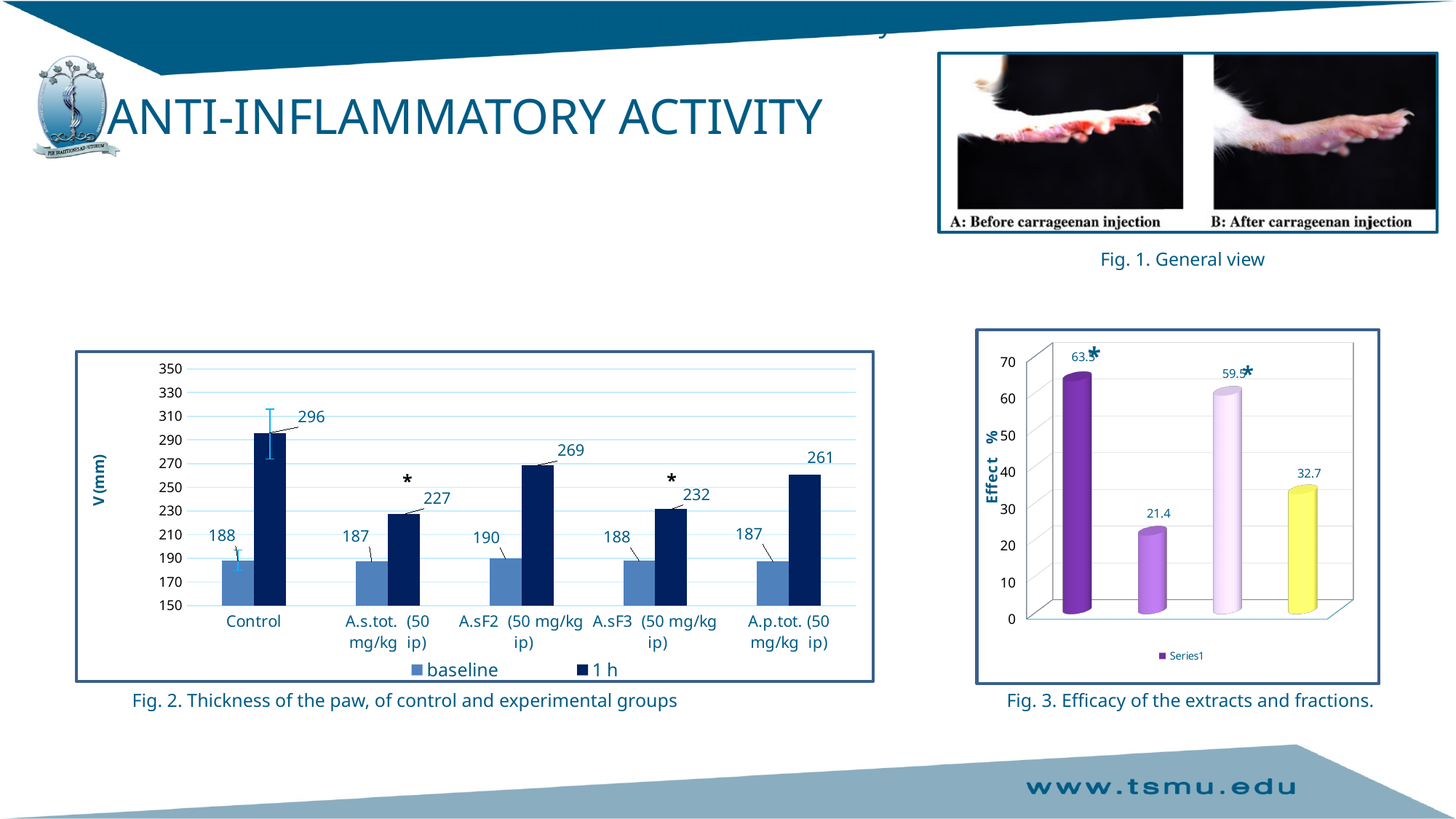
In Fig. 2, what is the difference between the 1 h and baseline values for A.p.tot. (50 mg/kg ip)? 74 In Fig. 2, what is the label of the y axis? V (mm) In Fig. 2, which is larger: the 1 h value for A.sF2 (50 mg/kg ip) or the 1 h value for A.sF3 (50 mg/kg ip)? A.sF2 (50 mg/kg ip) In Fig. 3, which bar has the lowest value? the second bar (21.4) In Fig. 3, what is the value of the first (leftmost) bar? 63.5 In Fig. 2, how many series does the legend list? 2 In Fig. 2, which group has the lowest 1 h value? A.s.tot. (50 mg/kg ip) In Fig. 2, how many groups are shown on the x axis? 5 What kind of chart is Fig. 3? bar chart In Fig. 2, what is the baseline value for A.sF2 (50 mg/kg ip)? 190 In Fig. 2, what is the 1 h value for the Control group? 296